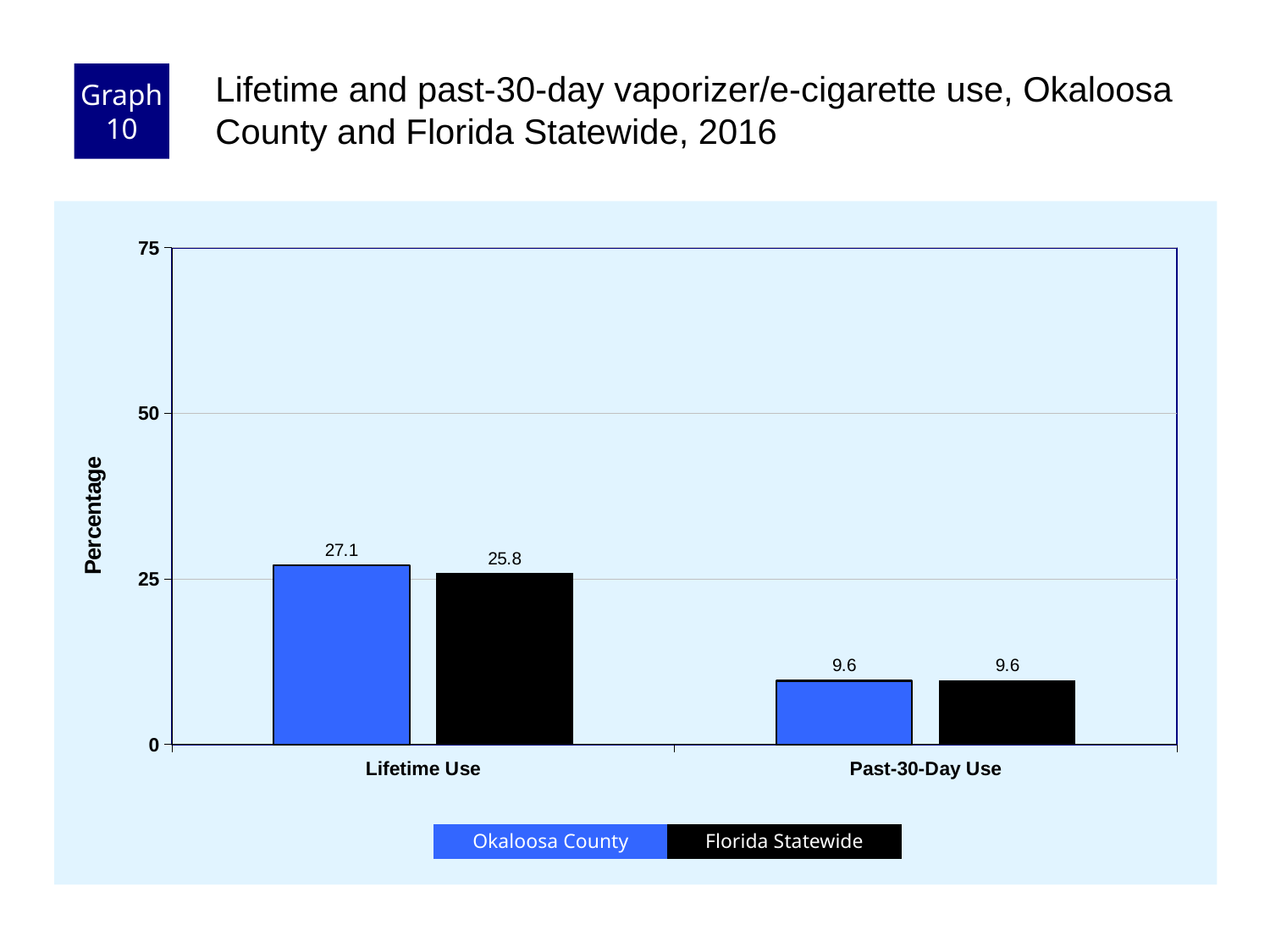
How many series does the legend list? 2 What is the Past-30-Day Use value for Florida Statewide? 9.6 Is the Lifetime Use value for Okaloosa County greater or less than 25? greater For Lifetime Use, which is larger: Okaloosa County or Florida Statewide? Okaloosa County What is the difference between the Okaloosa County and Florida Statewide values for Lifetime Use? 1.3 Which category has the highest value for Okaloosa County? Lifetime Use Which category has the lowest value for Florida Statewide? Past-30-Day Use What kind of chart is shown on the slide? bar chart What is the Lifetime Use value for Florida Statewide? 25.8 What is the Past-30-Day Use value for Okaloosa County? 9.6 How many categories are shown on the x axis? 2 What is the Lifetime Use value for Okaloosa County? 27.1